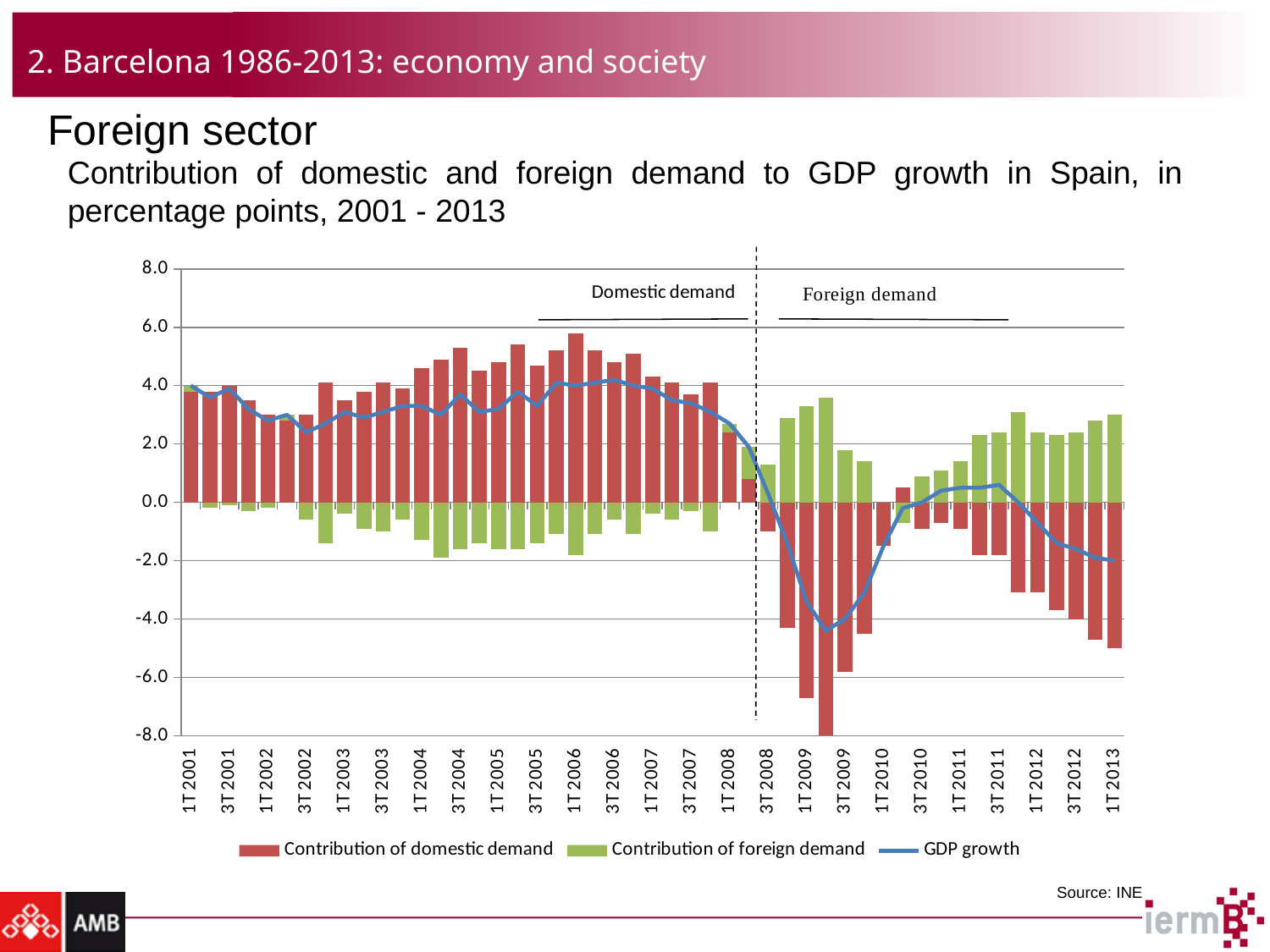
Which series is drawn as a line rather than bars? GDP growth Is the contribution of domestic demand in 1T 2006 greater or less than 4.0? greater Is the contribution of foreign demand in 1T 2009 greater or less than 2.0? greater What colour are the bars for the contribution of foreign demand? Green Among the labelled quarters, in which quarter is the contribution of domestic demand highest? 1T 2006 What kind of chart is shown on the slide? A bar chart with a line series Which is larger, the contribution of domestic demand in 1T 2006 or in 1T 2013? 1T 2006 Is the contribution of foreign demand in 1T 2006 greater or less than -1.0? less How many series does the legend list? 3 Does GDP growth rise or fall between 1T 2008 and 1T 2009? Falls